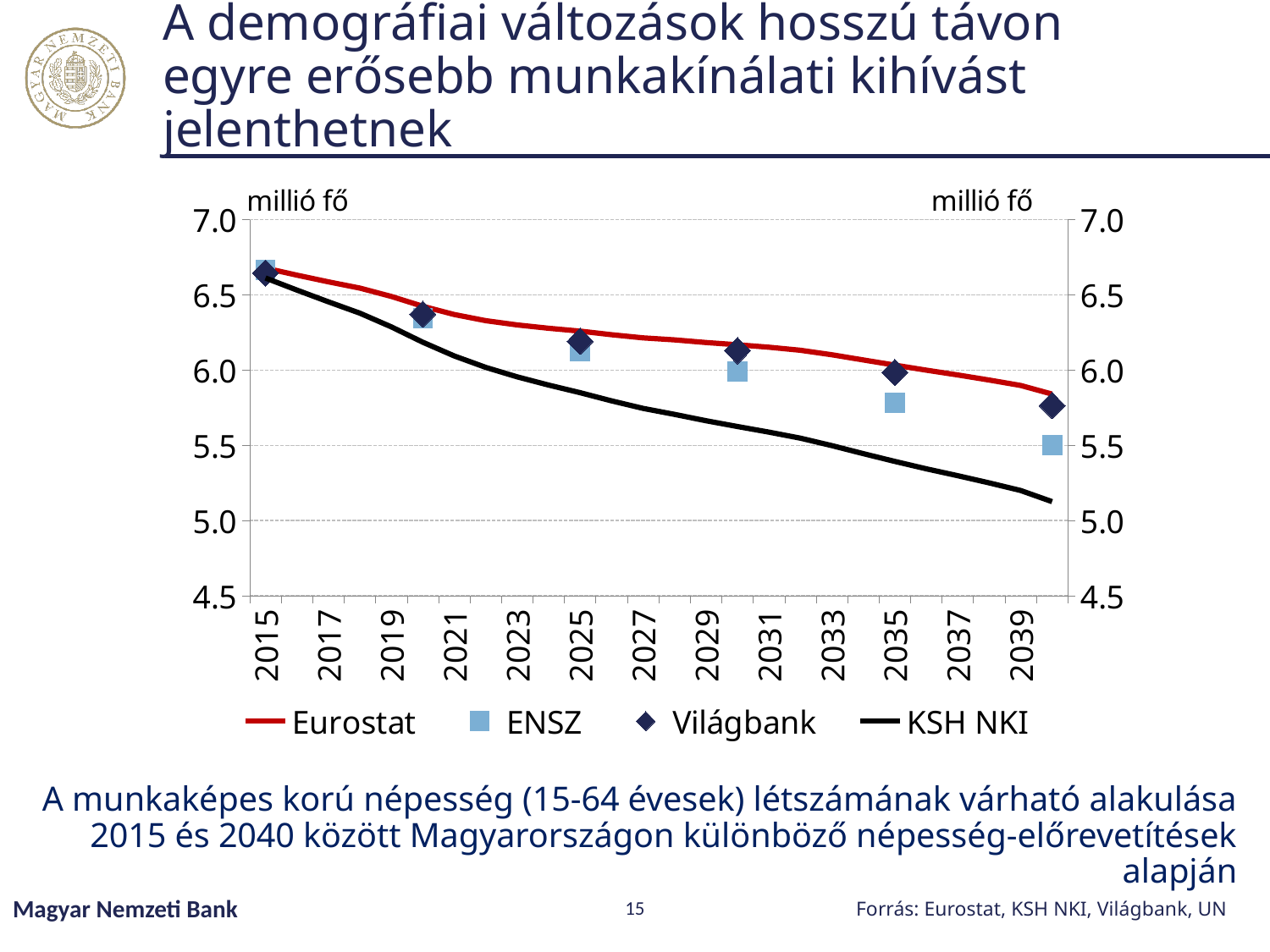
Is the value for KSH NKI at the end of the series (2040) greater or less than 5.5? less What unit is shown on the y axis of the chart? millió fő Is the value for KSH NKI in 2025 greater or less than 6.0? less What kind of chart is shown on the slide? line chart How many series does the legend list? 4 Does the Eurostat series rise or fall from 2015 to 2040? fall In 2040, which series has the higher value, Eurostat or KSH NKI? Eurostat Is the value for Eurostat at the end of the series (2040) greater or less than 5.5? greater Which series has the lowest value in 2040? KSH NKI In 2035, which series has the higher value, ENSZ or Világbank? Világbank Does the KSH NKI series rise or fall along the x axis? fall